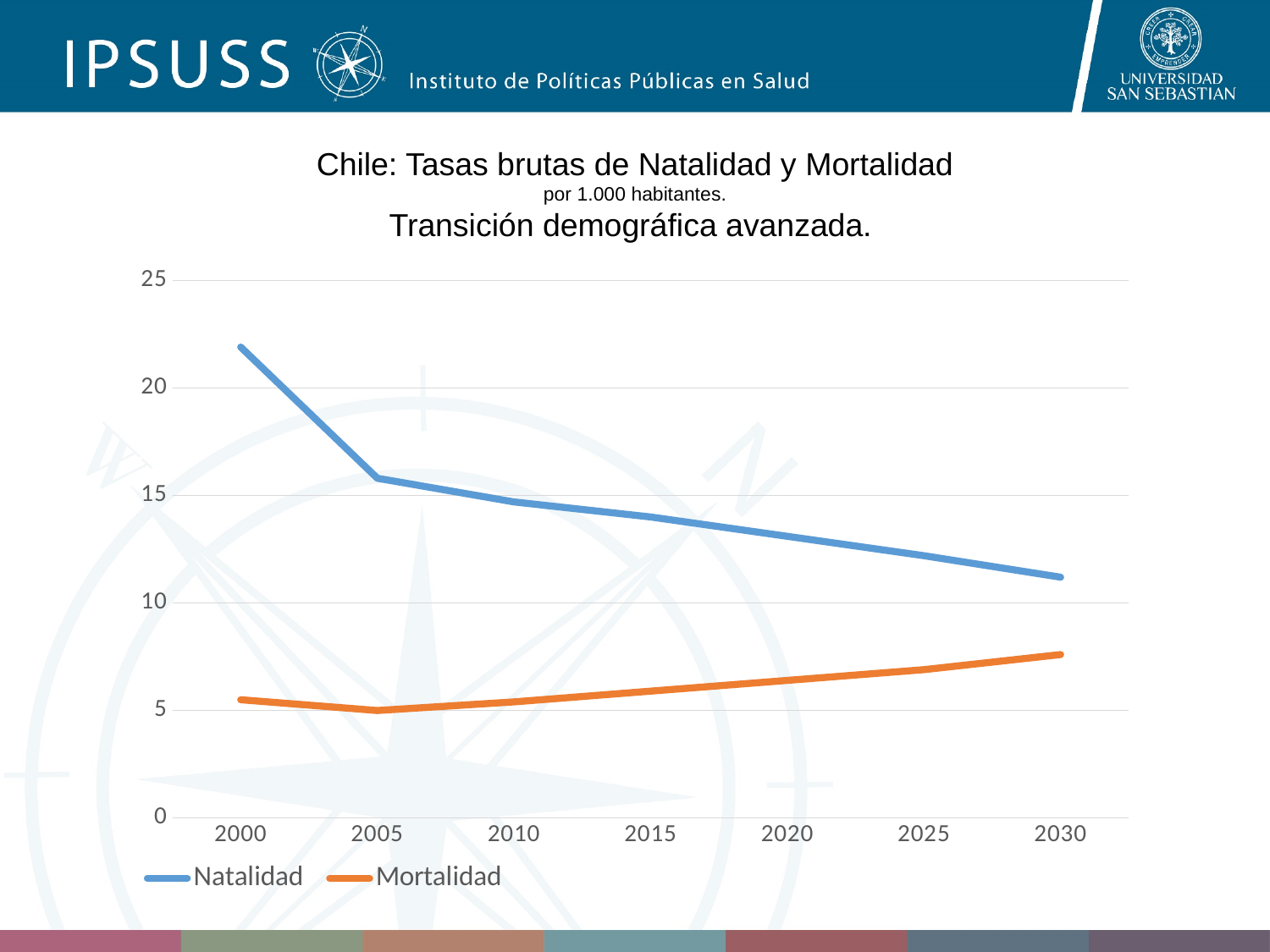
Does the Natalidad line rise or fall from 2000 to 2030? fall In which year is the Natalidad value lowest? 2030 In 2030, which series has the larger value, Natalidad or Mortalidad? Natalidad How many series does the legend list? 2 How many years are marked along the x axis? 7 Does the Mortalidad line rise or fall from 2005 to 2030? rise What kind of chart is shown on the slide? line chart In which year is the Mortalidad value highest? 2030 Which two series are listed in the legend? Natalidad and Mortalidad In which year is the Natalidad value highest? 2000 Is the Mortalidad value for 2030 greater or less than 10? less Is the Natalidad value for 2000 greater or less than 20? greater